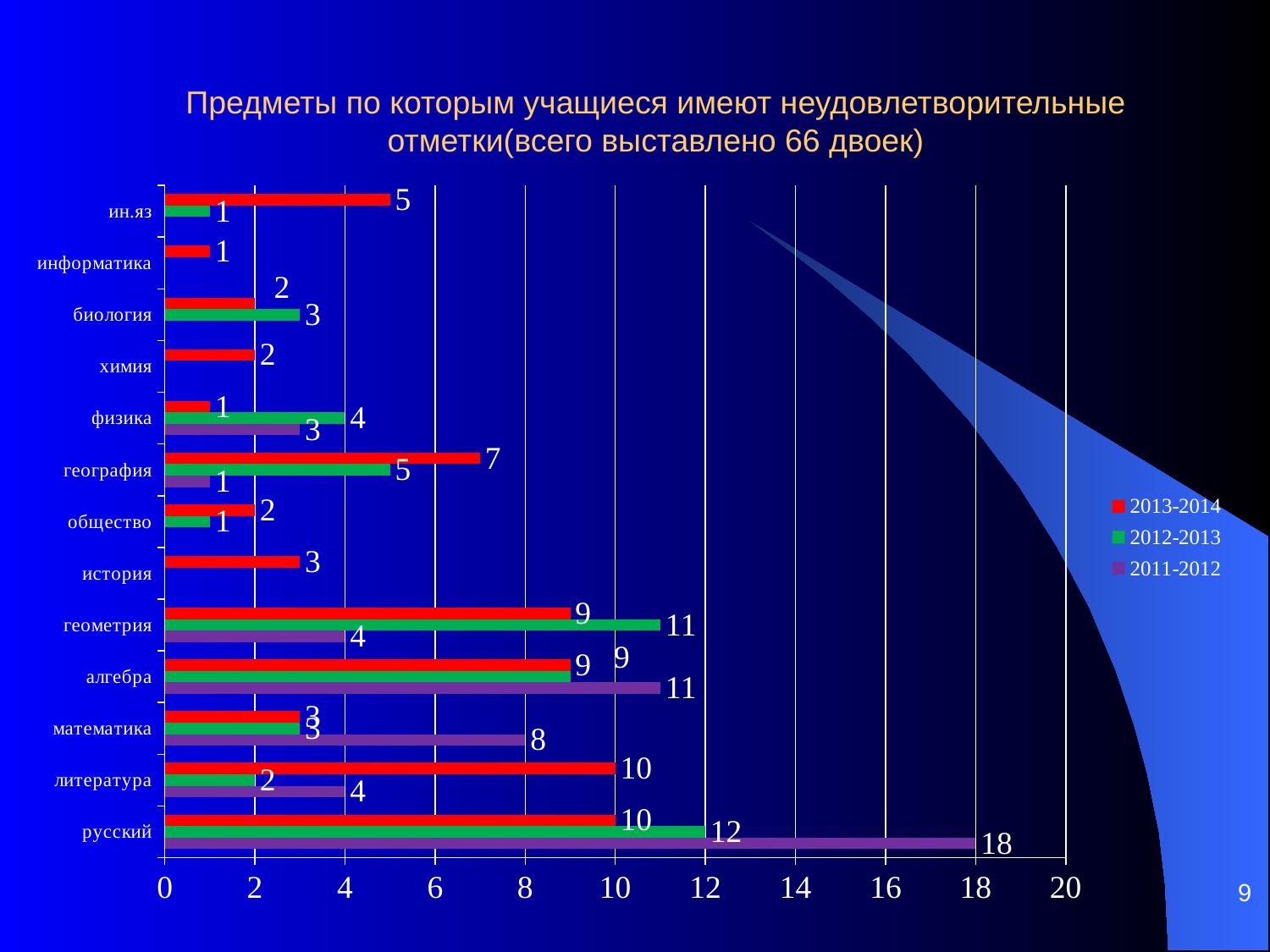
How many series does the legend list? 3 Which subject has the highest value in the 2012-2013 series? русский What is the difference between the 2012-2013 and 2013-2014 values for русский? 2 How many subjects are listed on the chart? 13 Which subject has the highest value in the 2011-2012 series? русский What is the value for русский in the 2011-2012 series? 18 What is the value for география in the 2013-2014 series? 7 For геометрия, which series has the larger value: 2012-2013 or 2013-2014? 2012-2013 What is the value for математика in the 2011-2012 series? 8 What kind of chart is shown on the slide? Bar chart What is the difference between the 2011-2012 and 2013-2014 values for алгебра? 2 What is the value for литература in the 2013-2014 series? 10